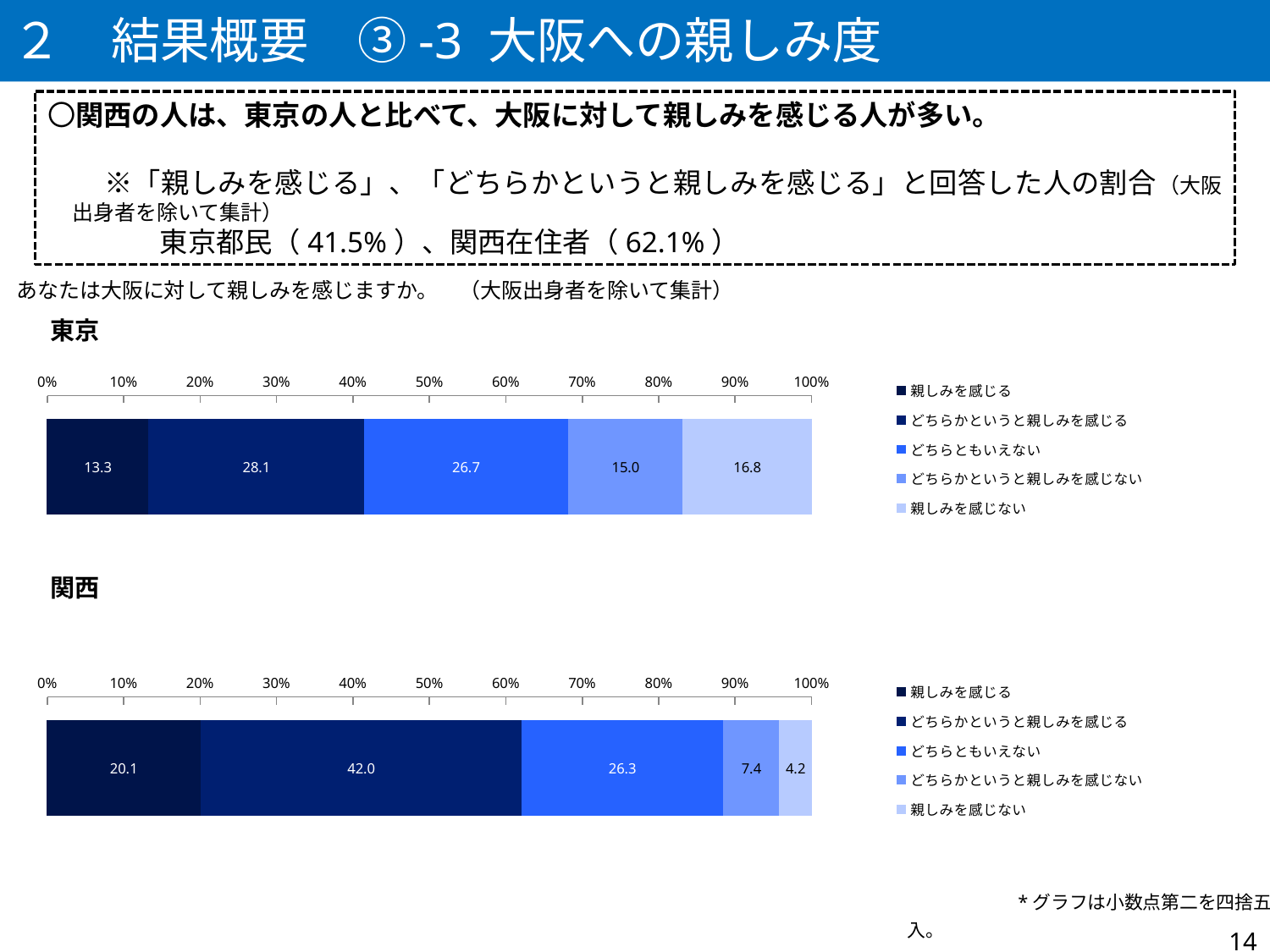
In the 関西 chart, what is the value for 親しみを感じない? 4.2 In the 東京 chart, what is the value for どちらかというと親しみを感じる? 28.1 In the 東京 chart, which segment has the largest value? どちらかというと親しみを感じる In the 関西 chart, what is the value for 親しみを感じる? 20.1 What is the difference between the どちらかというと親しみを感じる values in the 関西 chart and the 東京 chart? 13.9 Which is larger: the 親しみを感じない value in the 東京 chart or in the 関西 chart? 東京 In the 東京 chart, what is the value for どちらともいえない? 26.7 In the 東京 chart, what is the combined value of 親しみを感じる and どちらかというと親しみを感じる? 41.4 How many series does the legend of the 関西 chart list? 5 What kind of chart is the 東京 chart? Stacked bar chart In the 関西 chart, which segment has the smallest value? 親しみを感じない In the 関西 chart, what is the difference between どちらともいえない and どちらかというと親しみを感じない? 18.9